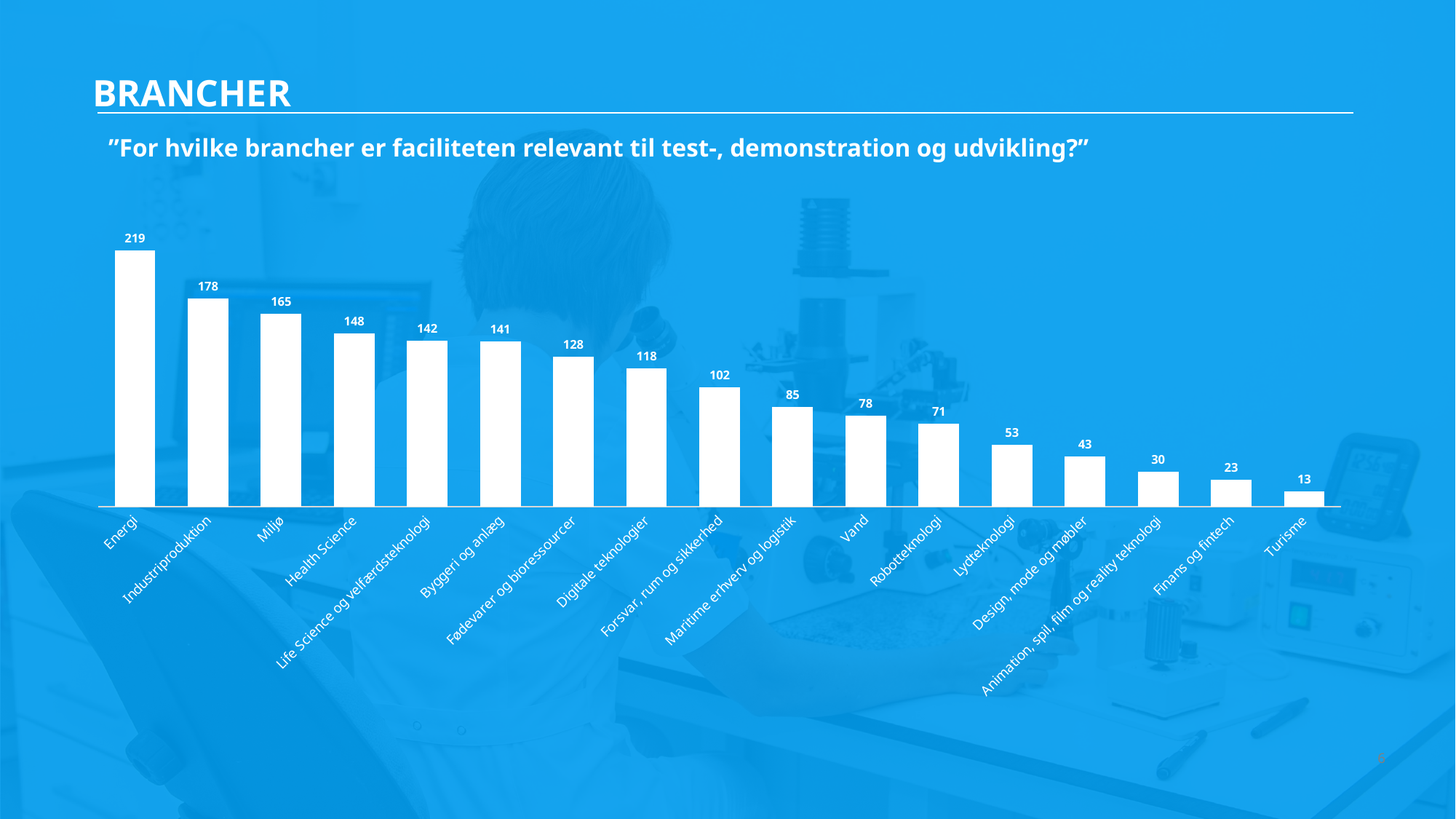
Which is larger, the value for Health Science or the value for Forsvar, rum og sikkerhed? Health Science Which category has the lowest value? Turisme Which category has the highest value? Energi What is the difference between the values for Industriproduktion and Miljø? 13 What is the value for Energi? 219 What kind of chart is shown on the slide? Bar chart How many categories are shown in the chart? 17 What is the value for Robotteknologi? 71 What is the difference between the values for Vand and Turisme? 65 Do the values rise or fall from left to right along the x axis? Fall What is the title of the slide? BRANCHER What is the value for Digitale teknologier? 118